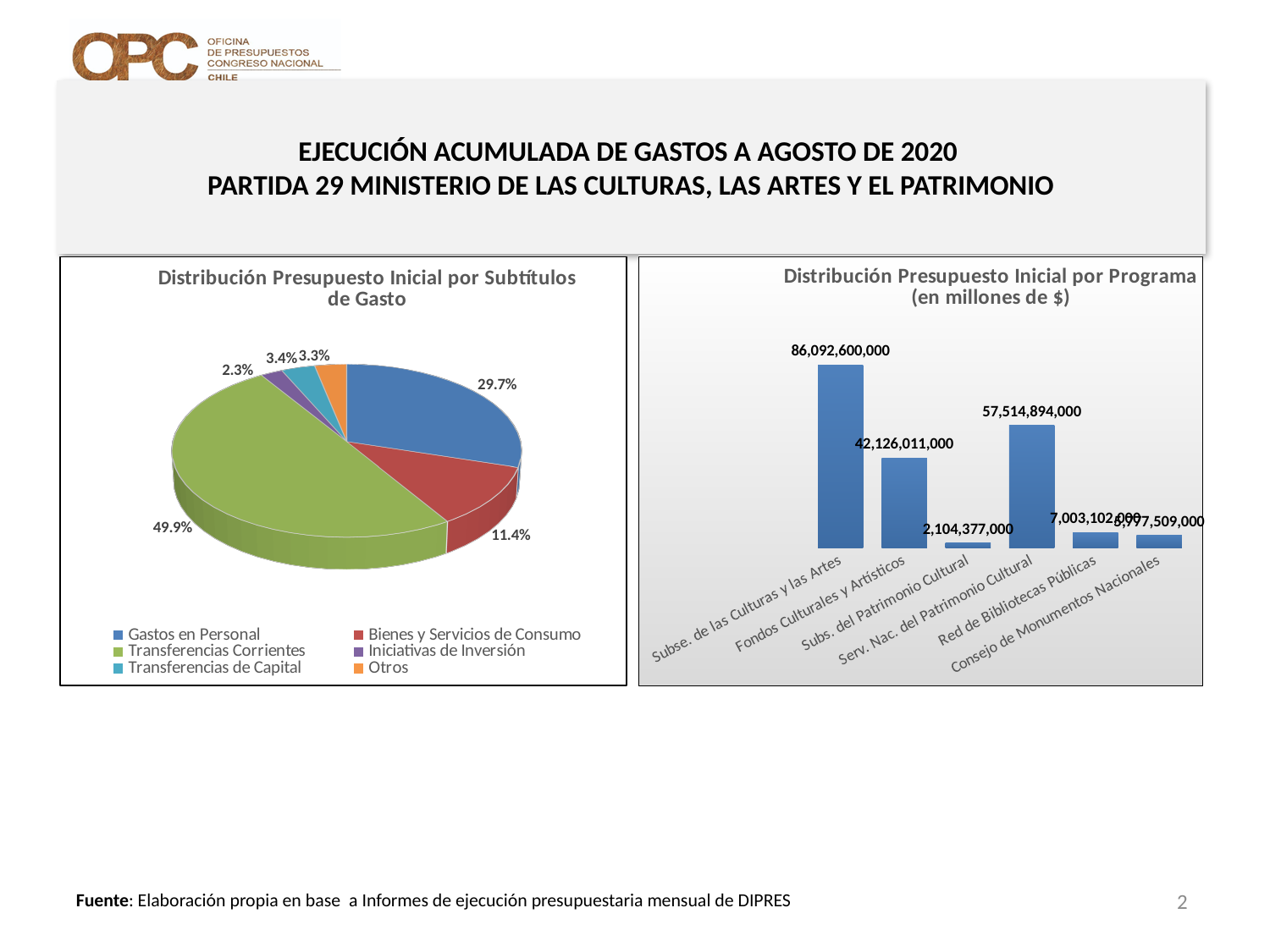
In the pie chart on the left, which category has the largest share? Transferencias Corrientes How many categories does the legend of the pie chart on the left list? 6 In the pie chart on the left, what share does Gastos en Personal have? 29.7% In the bar chart on the right, which program has the lowest value? Subs. del Patrimonio Cultural In the pie chart on the left, what share does Transferencias Corrientes have? 49.9% In the bar chart on the right, what is the value for Serv. Nac. del Patrimonio Cultural? 57,514,894,000 In the bar chart on the right, what is the value for Subse. de las Culturas y las Artes? 86,092,600,000 In the bar chart on the right, which is larger: Fondos Culturales y Artísticos or Serv. Nac. del Patrimonio Cultural? Serv. Nac. del Patrimonio Cultural In the pie chart on the left, what share does Bienes y Servicios de Consumo have? 11.4% In the pie chart on the left, which category has the smallest share? Iniciativas de Inversión What kind of chart is the 'Distribución Presupuesto Inicial por Subtítulos de Gasto' chart on the left? Pie chart What kind of chart is the 'Distribución Presupuesto Inicial por Programa' chart on the right? Bar chart